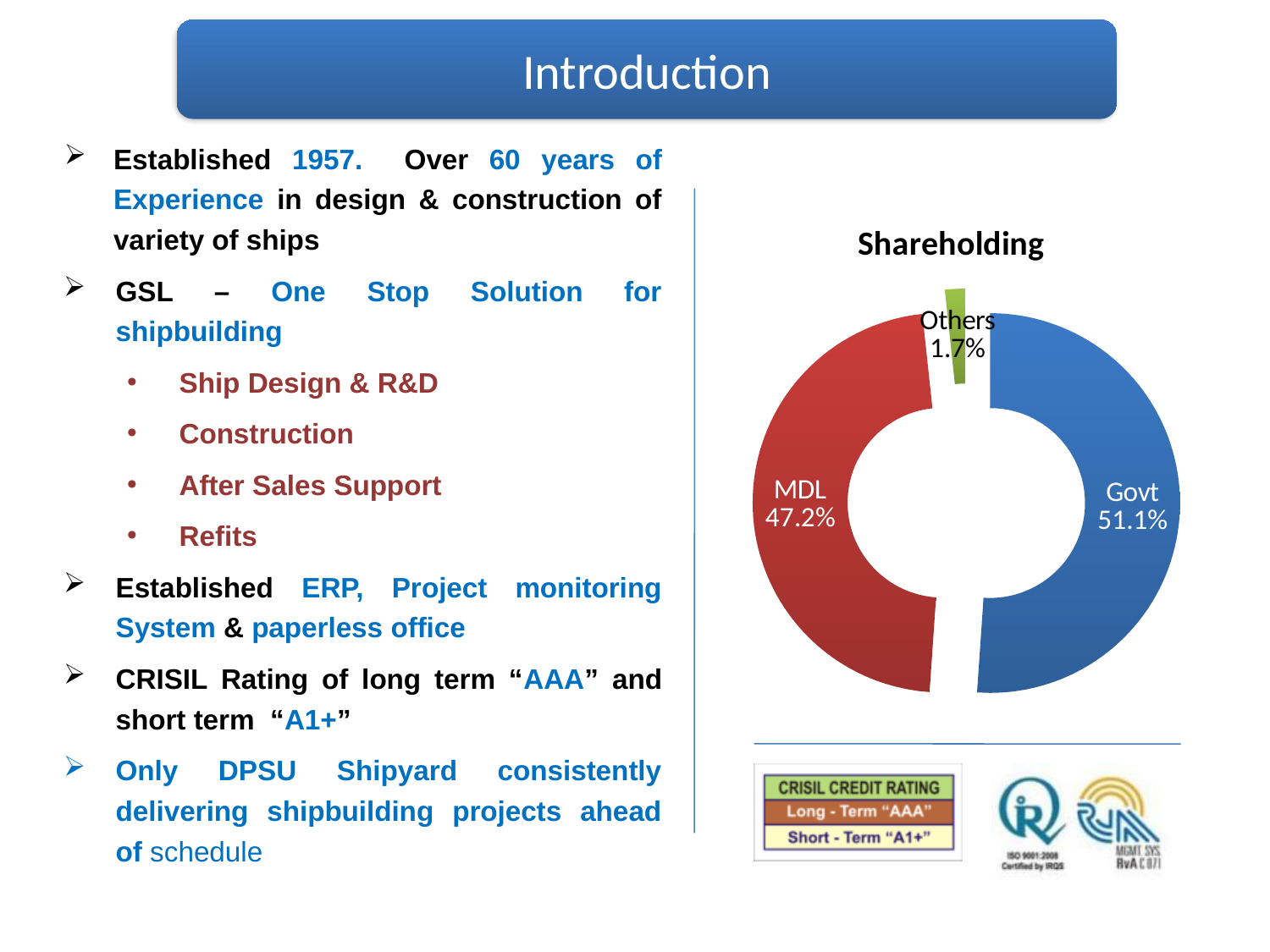
Which category has the largest share in the Shareholding chart? Govt What kind of chart is the Shareholding chart? doughnut chart What share of the Shareholding chart does Govt hold? 51.1% In the Shareholding chart, which is larger, the Govt share or the MDL share? Govt What colour is the Govt slice in the Shareholding chart? blue How many categories are shown in the Shareholding chart? 3 In the Shareholding chart, what is the difference between the Govt share and the MDL share? 3.9% In the Shareholding chart, what is the difference between the MDL share and the Others share? 45.5% Which category has the smallest share in the Shareholding chart? Others What share of the Shareholding chart does Others hold? 1.7% What share of the Shareholding chart does MDL hold? 47.2% What is the title of the chart on the slide? Shareholding